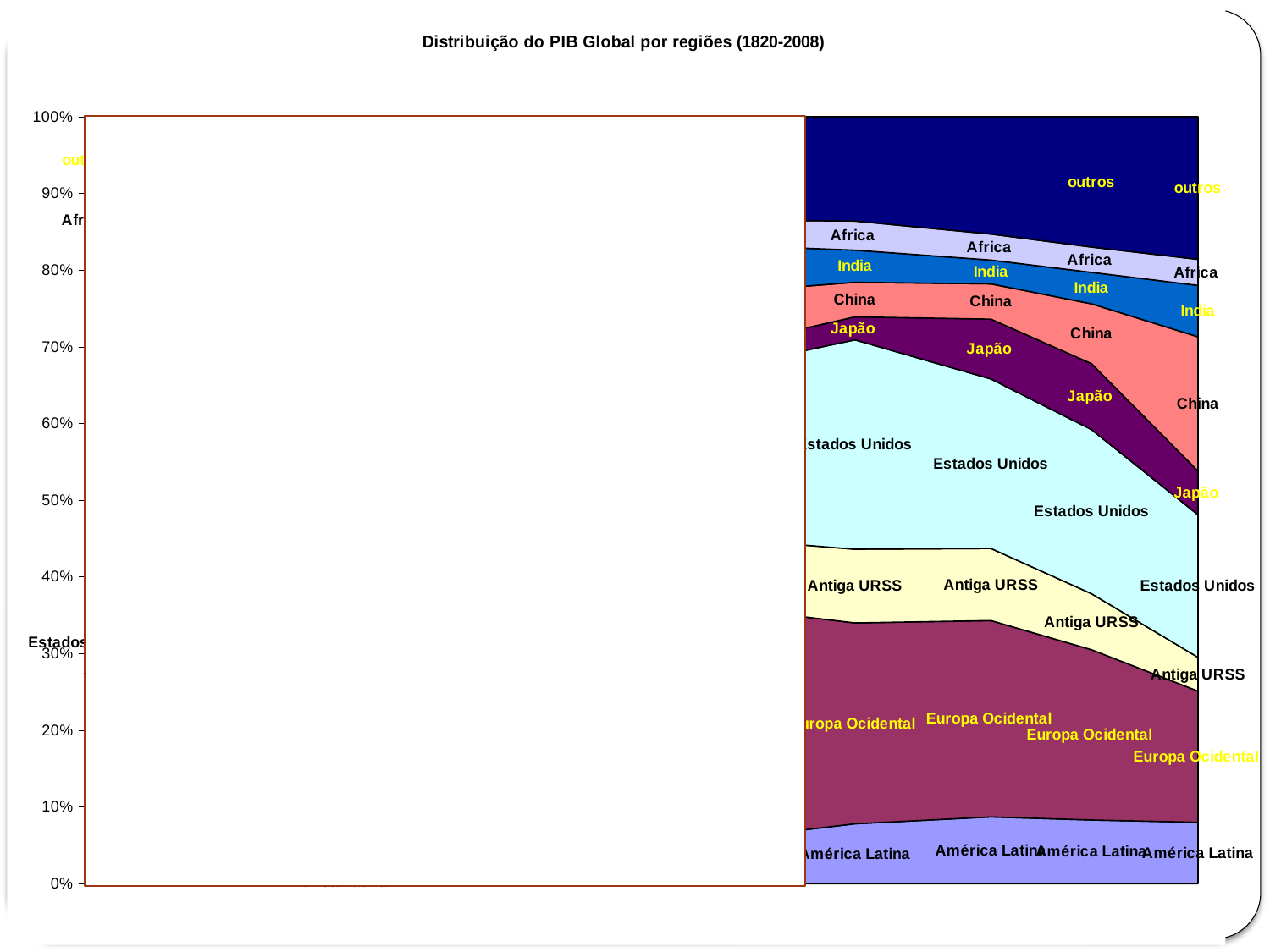
How many regions are labelled in the stacked areas of the chart? 9 What is the maximum value shown on the vertical axis of the chart? 100% What kind of chart is shown on the slide? Stacked area chart Does the share of Europa Ocidental rise or fall toward the right-hand end of the chart? Fall Does the share of 'outros' rise or fall toward the right-hand end of the chart? Rise Does the share of Estados Unidos rise or fall toward the right-hand end of the chart? Fall Which region forms the bottom band of the stacked area chart? América Latina What is the title of the chart? Distribuição do PIB Global por regiões (1820-2008)